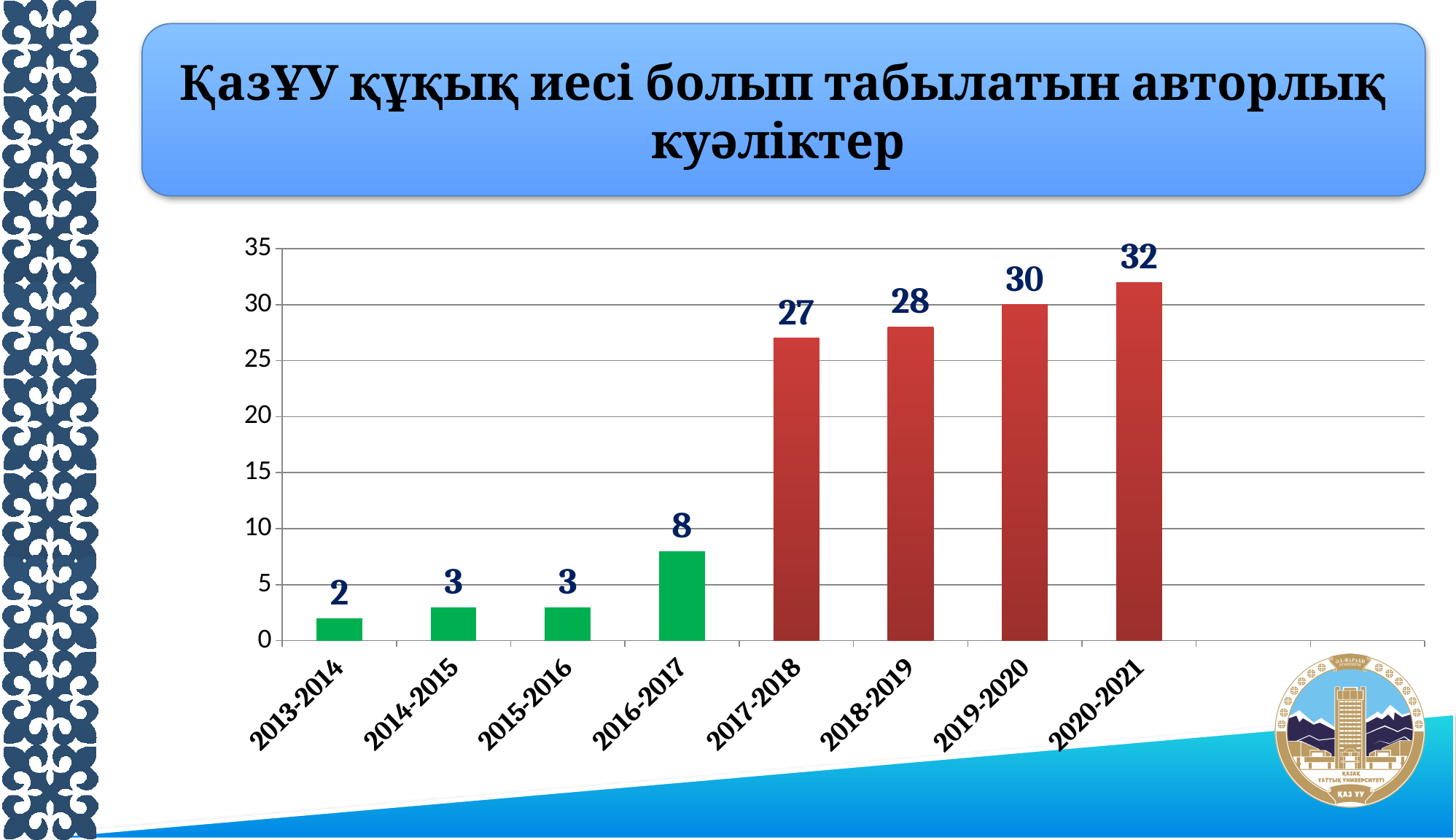
How many periods are shown on the x axis? 8 Do the values rise or fall from 2013-2014 to 2020-2021? rise Which period has the lowest value? 2013-2014 Which is larger, the value for 2017-2018 or the value for 2019-2020? 2019-2020 What is the difference between the values for 2019-2020 and 2018-2019? 2 Which period has the highest value? 2020-2021 What is the value for 2017-2018? 27 What is the value for 2016-2017? 8 What kind of chart is shown on the slide? bar chart Is the value for 2018-2019 greater or less than 25? greater What is the difference between the values for 2020-2021 and 2016-2017? 24 What is the value for 2013-2014? 2